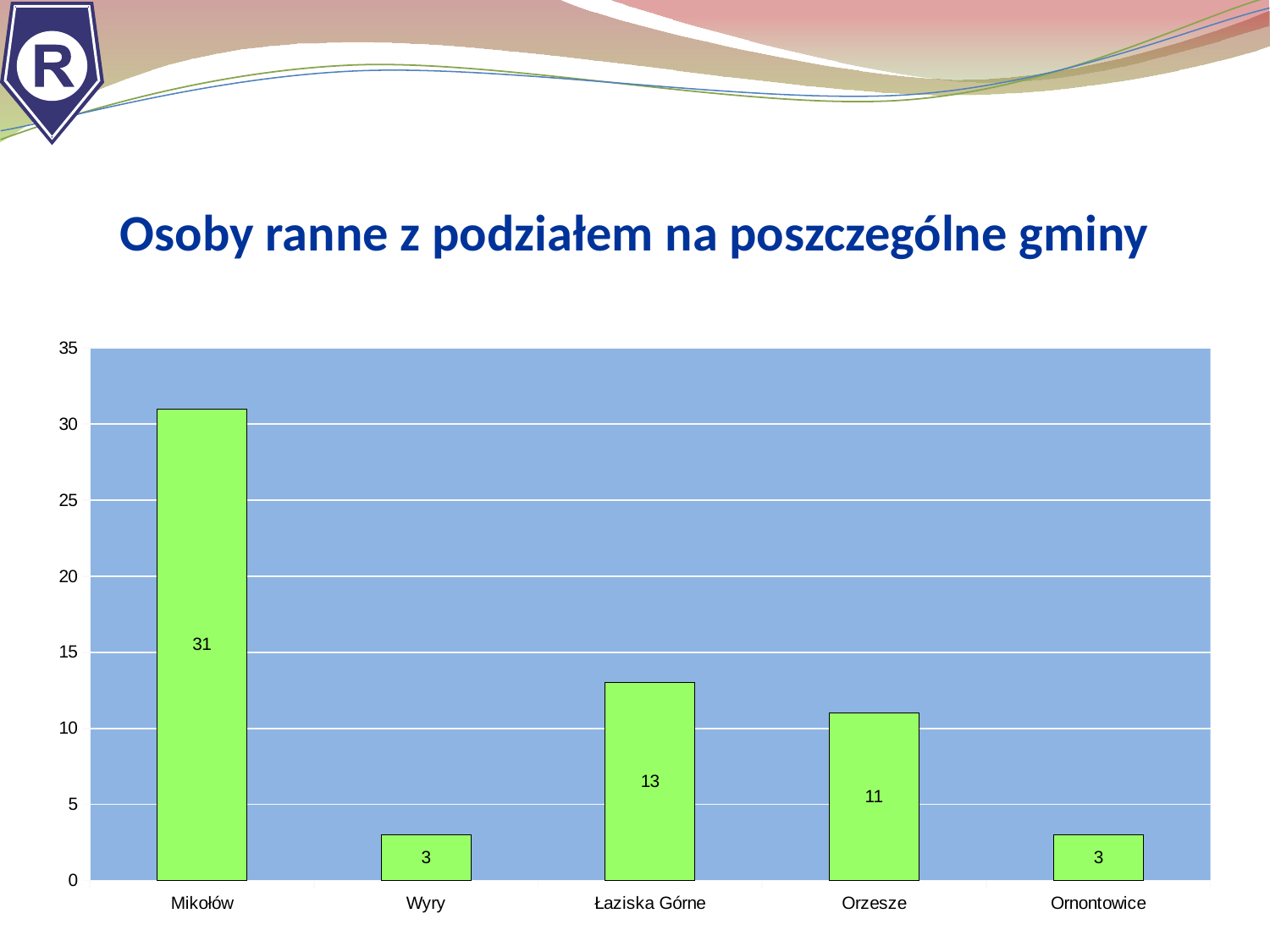
What is the value for Mikołów? 31 Is the value for Mikołów greater or less than 30? greater Which gmina has the highest number of injured persons? Mikołów Which is larger, the value for Orzesze or the value for Ornontowice? Orzesze What kind of chart is shown on the slide? bar chart What is the value for Orzesze? 11 What is the value for Wyry? 3 What is the difference between the values for Mikołów and Łaziska Górne? 18 What is the value for Łaziska Górne? 13 What is the difference between the values for Łaziska Górne and Orzesze? 2 What is the title of the slide? Osoby ranne z podziałem na poszczególne gminy How many gminy (categories) are shown on the chart? 5